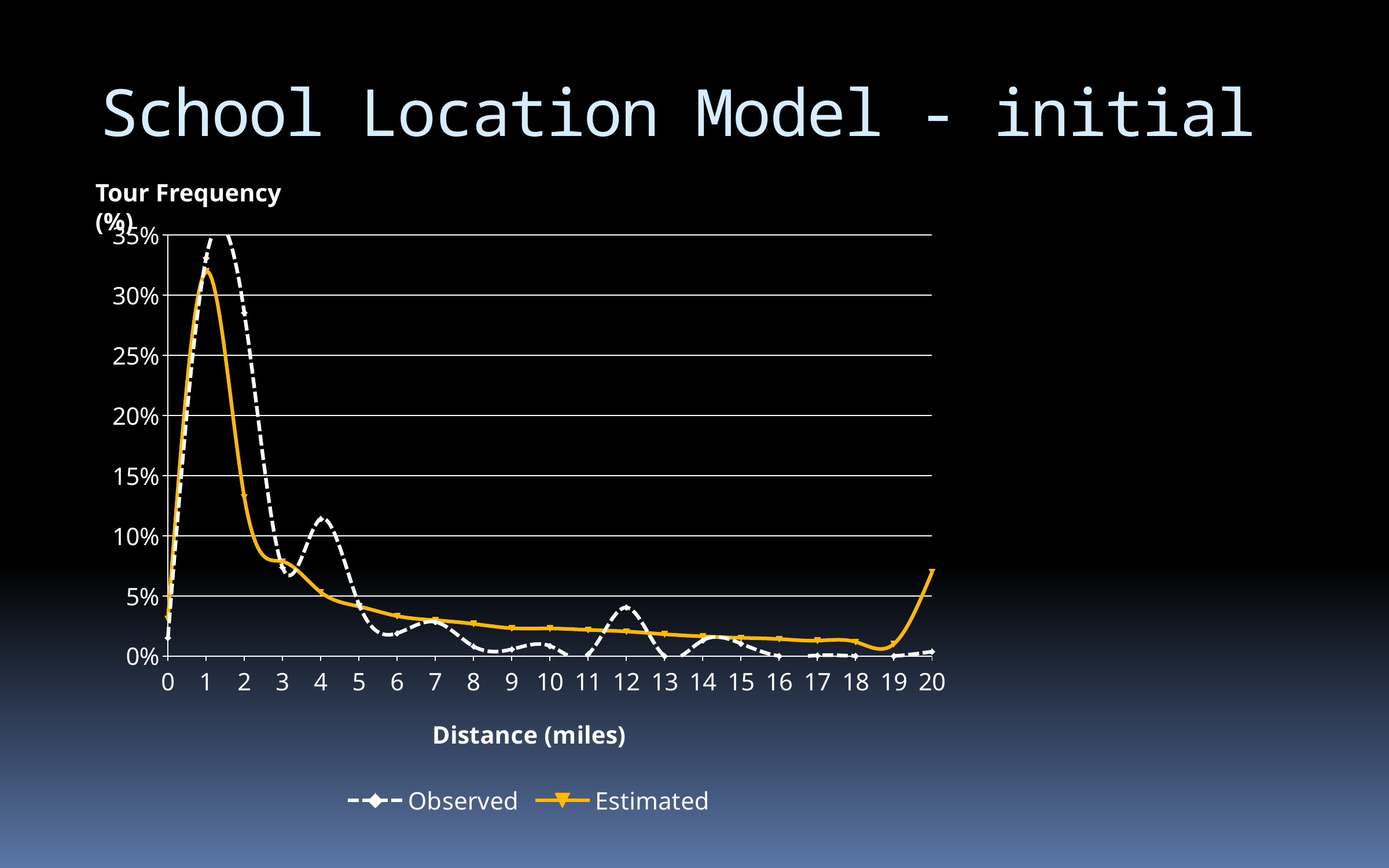
What are the two series named in the legend? Observed and Estimated Is the Estimated value at 2 miles greater or less than 10%? greater Is the Estimated value at 20 miles greater or less than 5%? greater At which distance does the Estimated series reach its highest value? 1 Does the Estimated series rise or fall between 5 and 19 miles? fall What is the title of the x axis? Distance (miles) Is the Observed value at 4 miles greater or less than 10%? greater What kind of chart is shown on the slide? line chart How many series does the legend list? 2 At 20 miles, which series has the higher value, Observed or Estimated? Estimated At 1 mile, which series has the higher value, Observed or Estimated? Observed